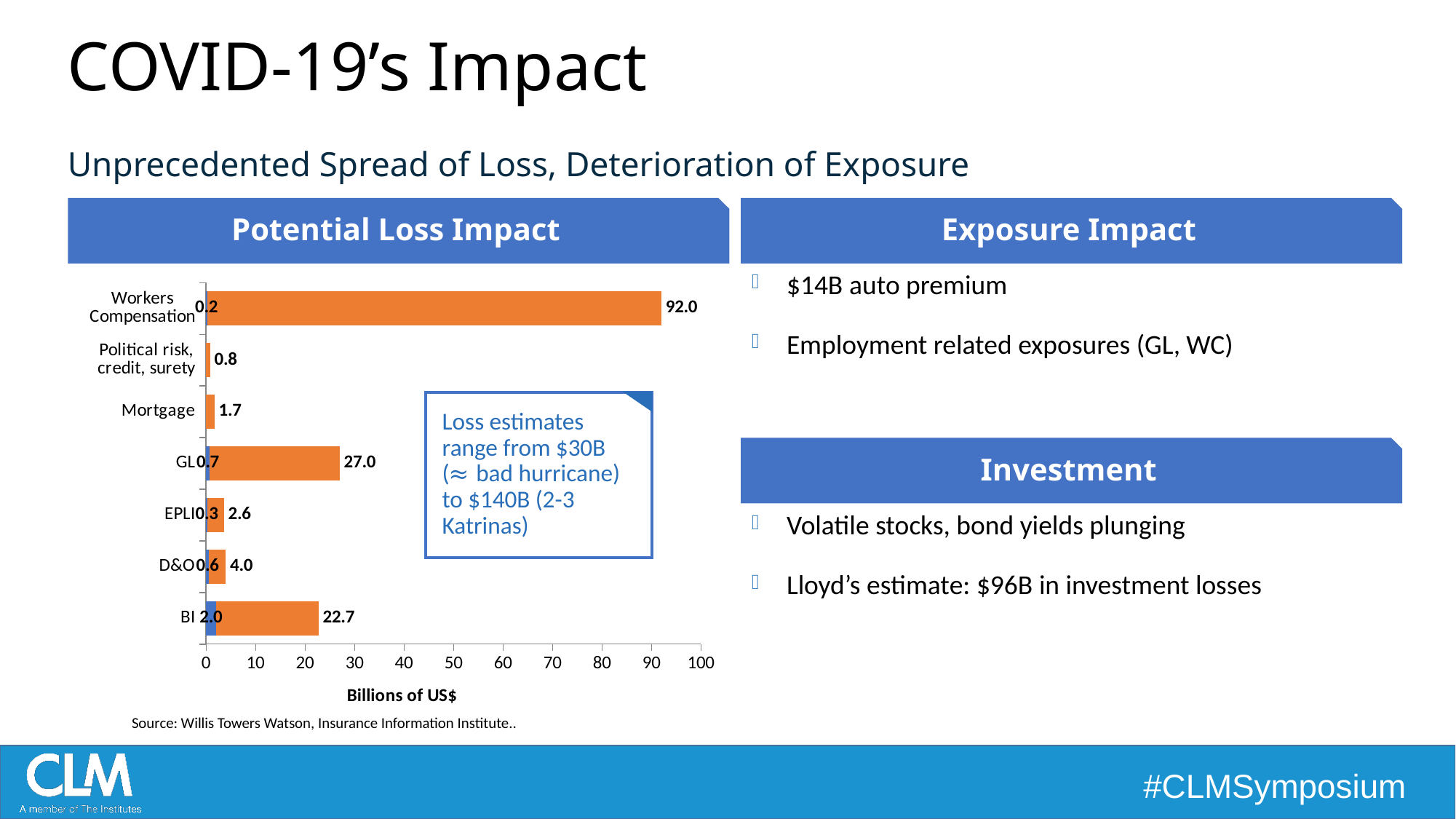
What is the x-axis title of the Potential Loss Impact chart? Billions of US$ What kind of chart is shown under "Potential Loss Impact"? Bar chart In the Potential Loss Impact chart, what is the value of the orange bar for BI? 22.7 In the Potential Loss Impact chart, what is the value of the orange bar for GL? 27.0 In the Potential Loss Impact chart, which category has the longest orange bar? Workers Compensation In the Potential Loss Impact chart, what is the value of the blue bar for BI? 2.0 In the Potential Loss Impact chart, what is the difference between the orange bar values for Workers Compensation and GL? 65.0 How many categories are shown on the y axis of the Potential Loss Impact chart? 7 In the Potential Loss Impact chart, what value is labelled for Mortgage? 1.7 In the Potential Loss Impact chart, which has the larger orange bar value, GL or BI? GL In the Potential Loss Impact chart, what is the value of the orange bar for Workers Compensation? 92.0 In the Potential Loss Impact chart, is the orange bar value for D&O greater or less than 10? less